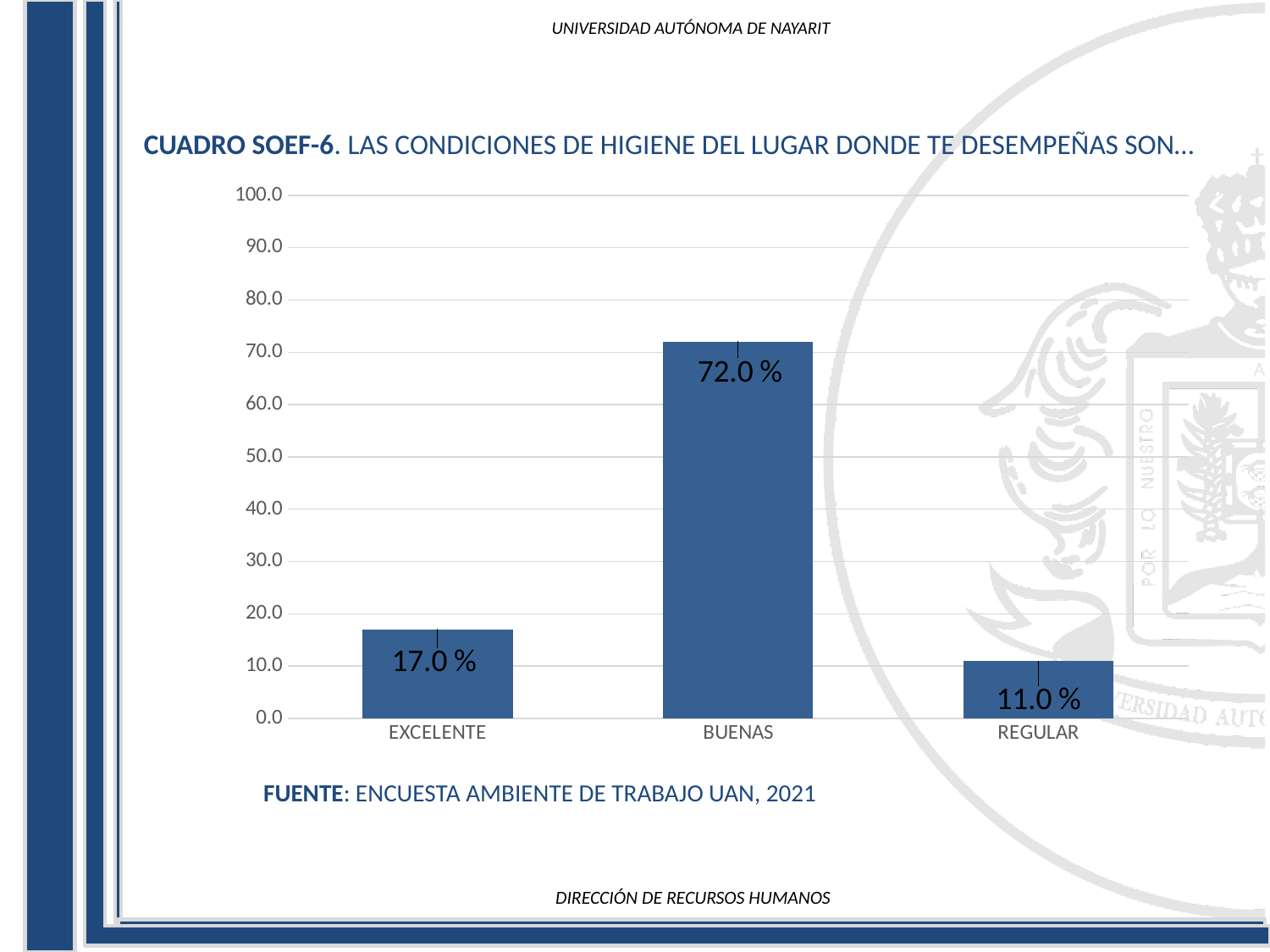
Which category has the lowest value? REGULAR How many categories are shown on the x axis? 3 What is the difference between the values for EXCELENTE and REGULAR? 6.0 % What is the value for BUENAS? 72.0 % What is the difference between the values for BUENAS and EXCELENTE? 55.0 % Is the value for BUENAS greater or less than 50.0? greater Which is larger, the value for EXCELENTE or the value for REGULAR? EXCELENTE What source is cited below the chart? ENCUESTA AMBIENTE DE TRABAJO UAN, 2021 What kind of chart is shown on the slide? bar chart What is the value for EXCELENTE? 17.0 % What is the value for REGULAR? 11.0 % Which category has the highest value? BUENAS